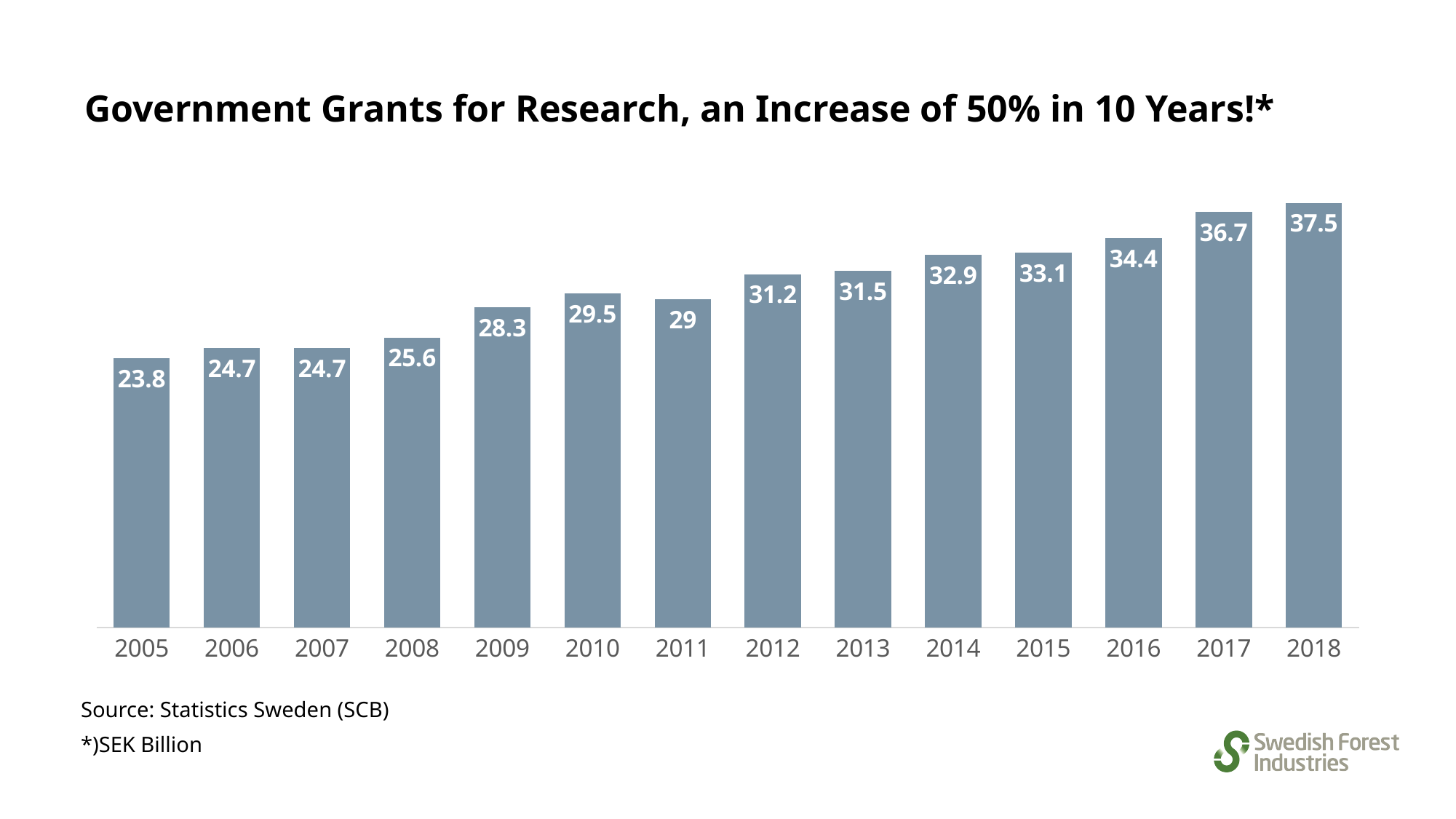
What is the title of the chart? Government Grants for Research, an Increase of 50% in 10 Years!* How many years are shown on the x axis? 14 What is the value for 2012? 31.2 Do the values generally rise or fall from 2005 to 2018? rise What is the value for 2005? 23.8 What kind of chart is this? bar chart Which year has the highest value? 2018 What is the difference between the values for 2010 and 2009? 1.2 Which year has the lowest value? 2005 What is the difference between the values for 2018 and 2005? 13.7 Which is larger, the value for 2014 or the value for 2011? 2014 What is the value for 2016? 34.4